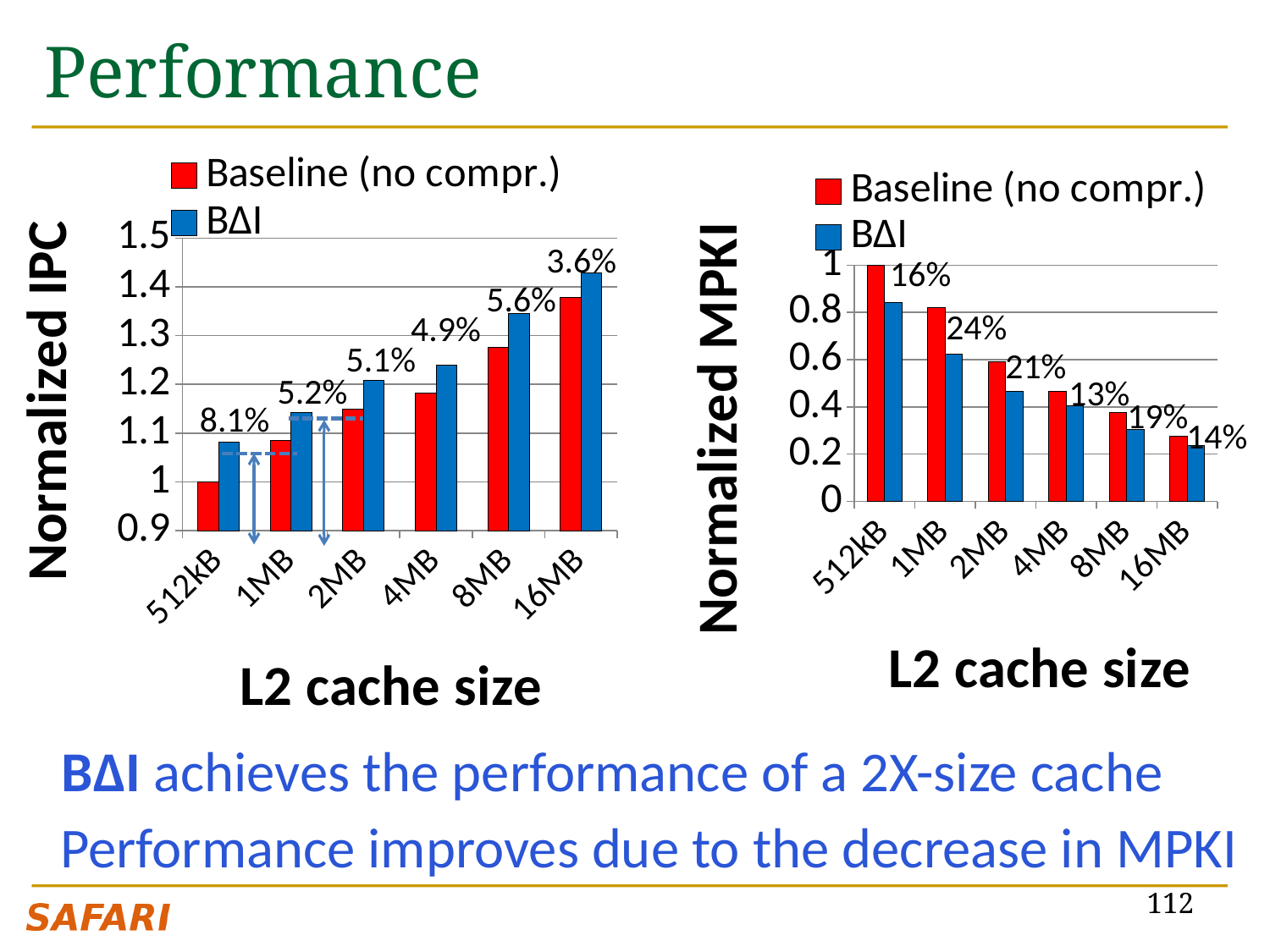
How many series does the legend of the Normalized MPKI chart list? 2 In the Normalized IPC chart, what is the difference between the percentage labels for 512kB and 16MB? 4.5% In the Normalized MPKI chart, is the Baseline (no compr.) value for 4MB greater or less than 0.4? greater How many L2 cache sizes are shown on the x axis of the Normalized IPC chart? 6 In the Normalized MPKI chart, do the Baseline (no compr.) bars rise or fall as the L2 cache size increases? Fall In the Normalized IPC chart, do the BΔI bars rise or fall as the L2 cache size increases? Rise In the Normalized IPC chart, what percentage label is shown above the 16MB bars? 3.6% In the Normalized IPC chart, which L2 cache size has the smallest percentage label? 16MB What kind of chart is the Normalized IPC chart on the left? Bar chart In the Normalized MPKI chart, which L2 cache size has the largest percentage label? 1MB In the Normalized MPKI chart, what percentage label is shown for 1MB? 24% In the Normalized IPC chart, what percentage label is shown above the 512kB bars? 8.1%